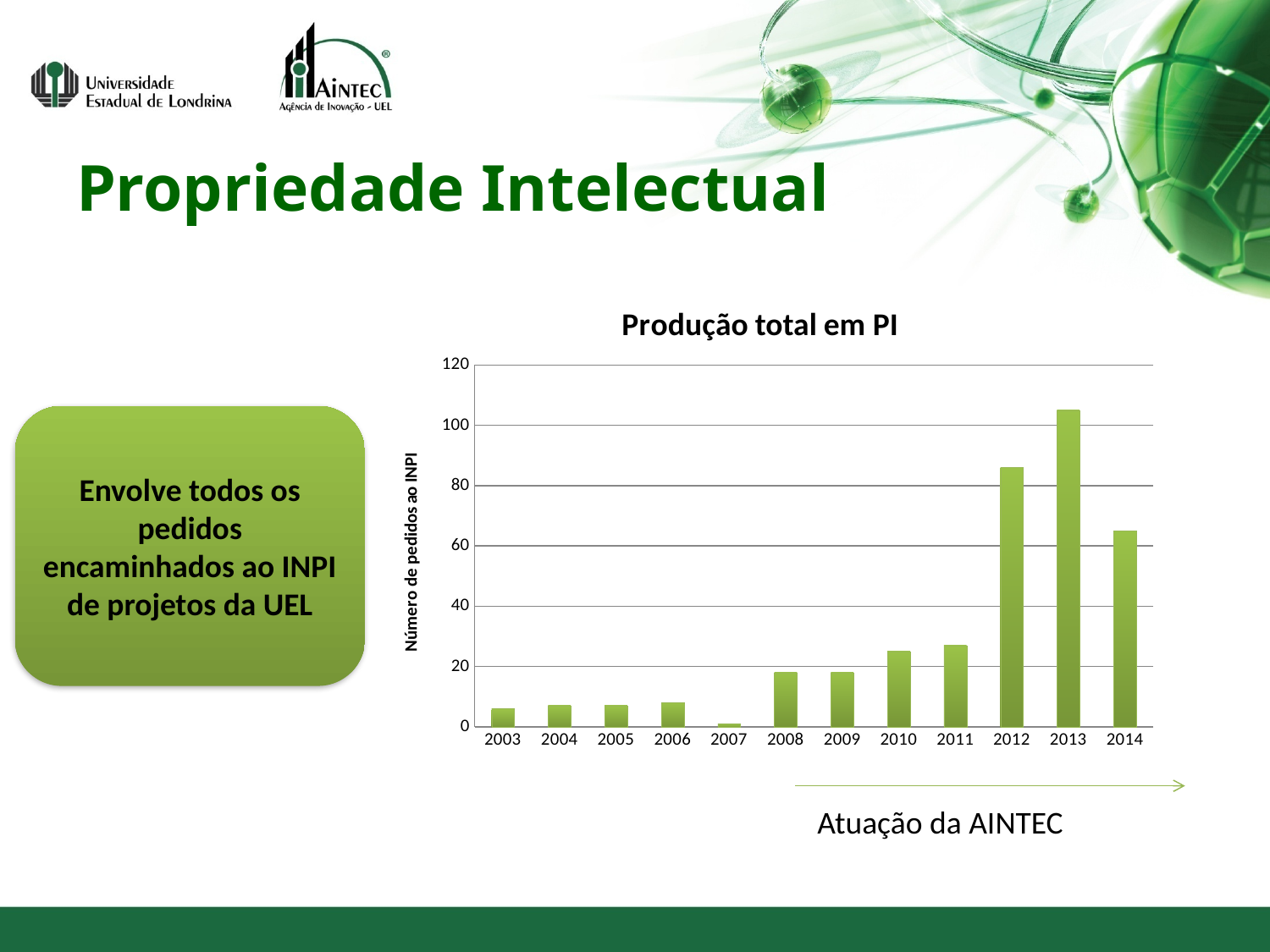
Is the value for 2012 greater or less than 80? greater What is the label of the vertical axis of the chart? Número de pedidos ao INPI Which year has a higher value, 2011 or 2012? 2012 Is the value for 2007 greater or less than 20? less What is the title of the chart? Produção total em PI How many years are shown on the x axis of the chart? 12 What type of chart is shown on the slide? bar chart Which year has the lowest number of pedidos ao INPI? 2007 Is the value for 2013 greater or less than 100? greater Which year has the highest number of pedidos ao INPI? 2013 Which year has a higher value, 2012 or 2014? 2012